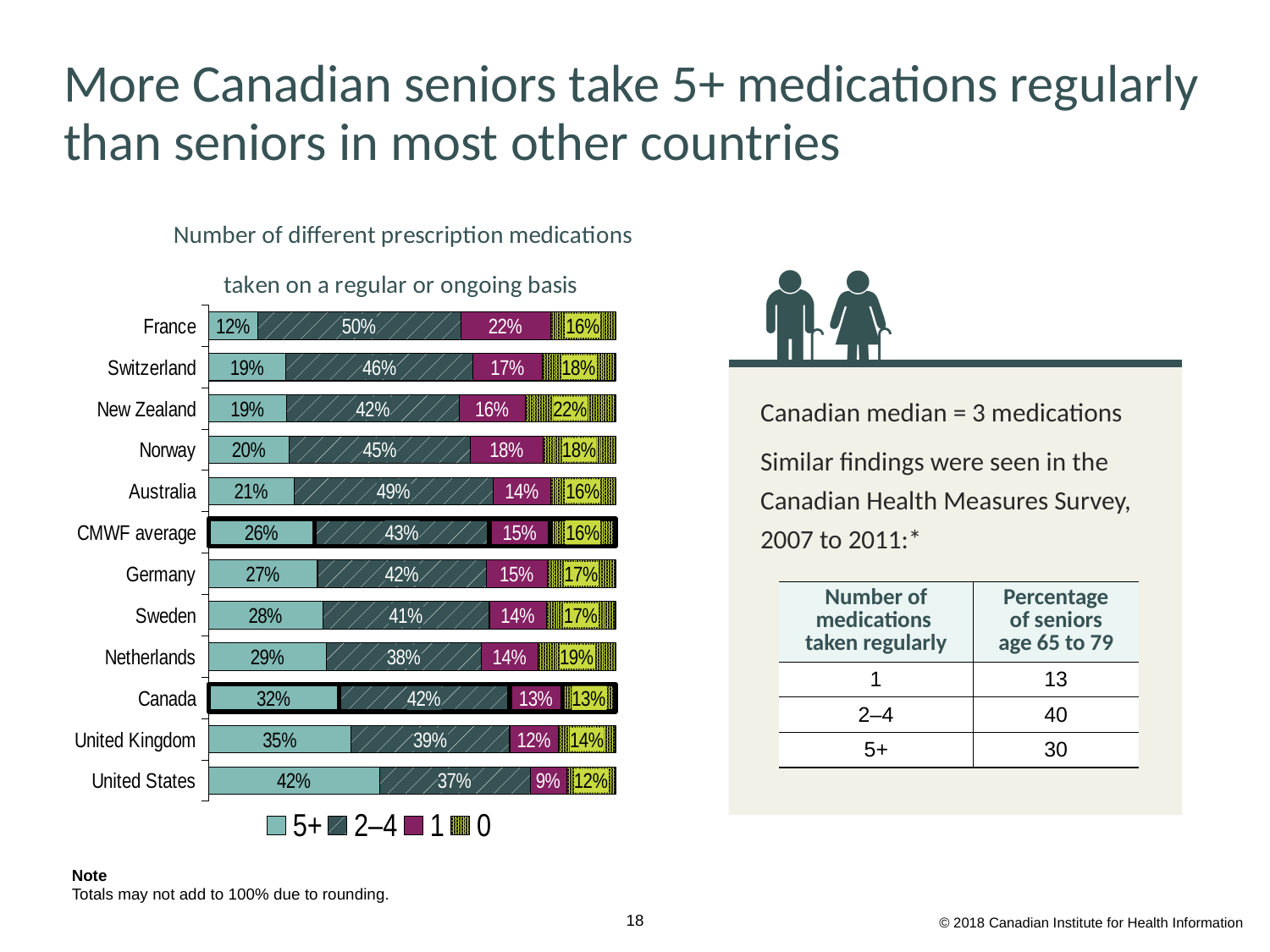
What percentage of seniors in New Zealand take 0 medications regularly? 22% What percentage of seniors in the United States take 5+ medications regularly? 42% What percentage of seniors in Canada take 2–4 medications regularly? 42% How many series does the chart legend list? 4 What percentage of seniors in France take 5+ medications regularly? 12% How many countries or categories are shown on the chart? 12 Which has a larger share of seniors taking 5+ medications, Canada or the United Kingdom? United Kingdom What kind of chart is shown on the slide? Stacked bar chart What is the total of the four segments in the Canada bar? 100% Which country has the lowest percentage of seniors taking 5+ medications? France How many percentage points higher is Canada's 5+ medications share than the CMWF average? 6 percentage points Which country has the highest percentage of seniors taking 5+ medications? United States